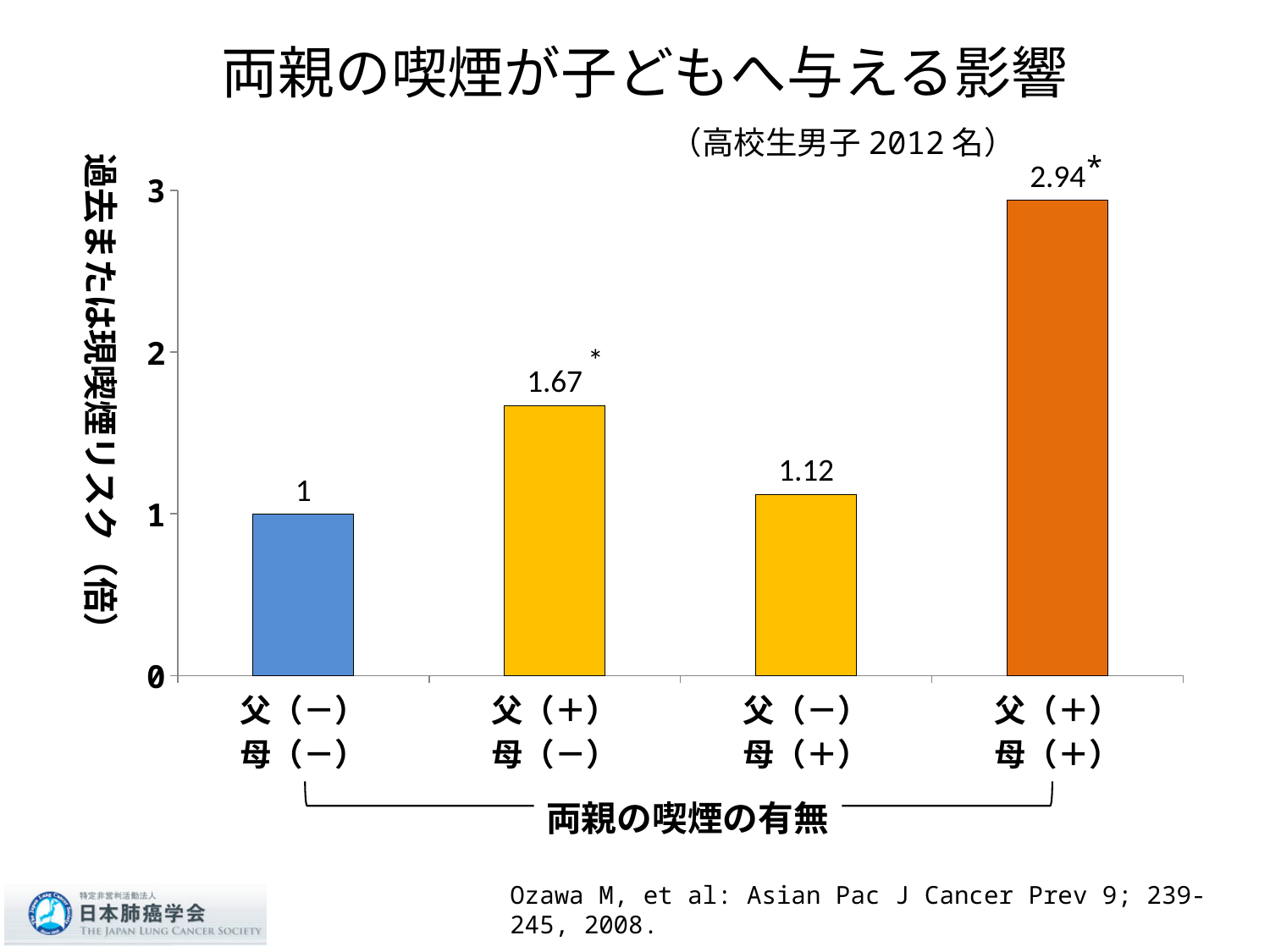
What is the difference between the values for 父（+）母（+） and 父（−）母（−）? 1.94 What is the value for 父（−）母（−）? 1 Is the value for 父（+）母（+） greater or less than 2? greater What is the value for 父（+）母（−）? 1.67 Which is larger, the value for 父（+）母（−） or the value for 父（−）母（+）? 父（+）母（−） How many categories are shown on the x axis? 4 Which category has the highest value? 父（+）母（+） What is the value for 父（−）母（+）? 1.12 What is the difference between the values for 父（+）母（−） and 父（−）母（+）? 0.55 What is the value for 父（+）母（+）? 2.94 What kind of chart is shown on the slide? bar chart Which category has the lowest value? 父（−）母（−）